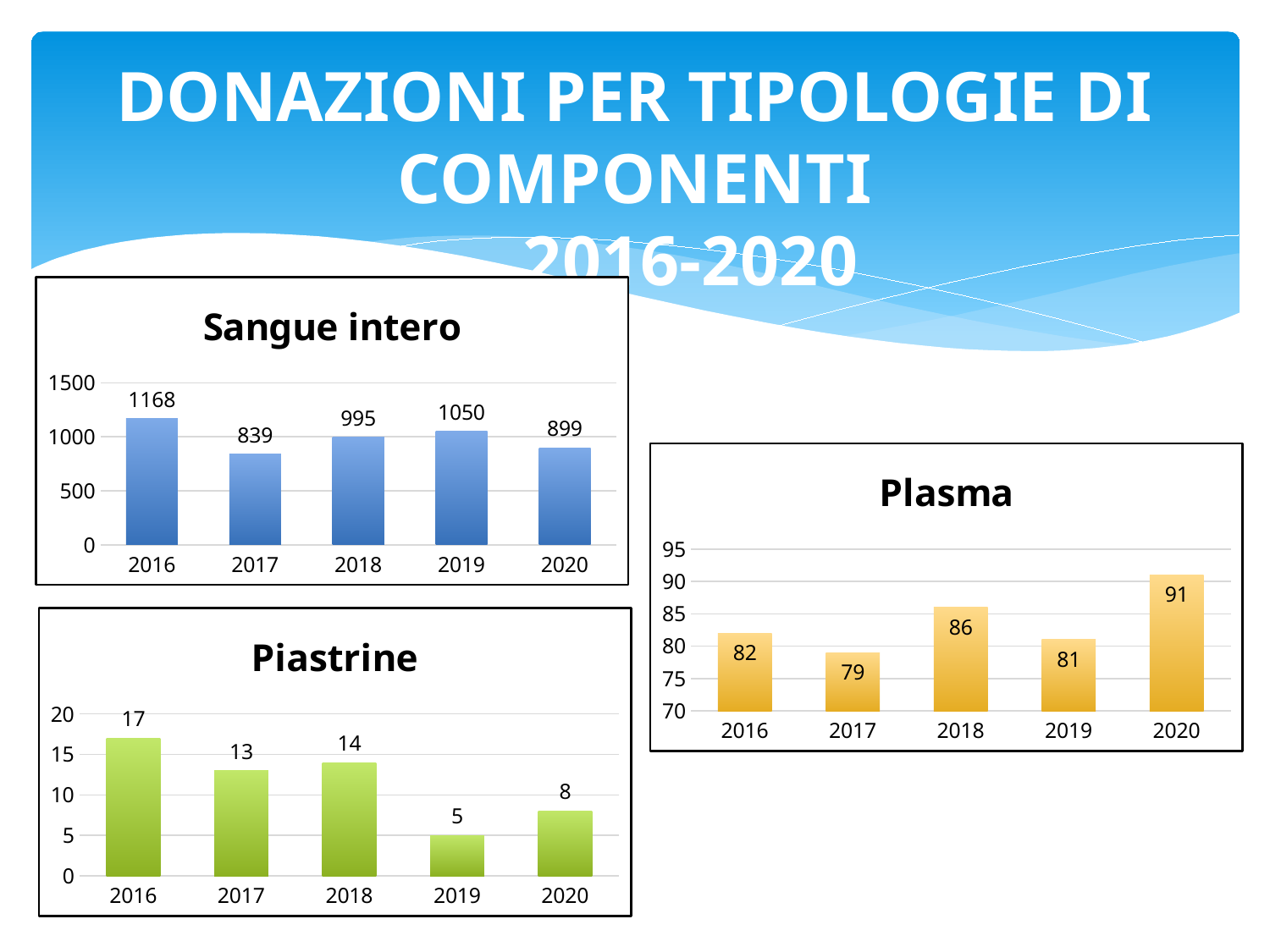
In the 'Sangue intero' chart, which year has the lowest value? 2017 In the 'Sangue intero' chart, what is the difference between the values for 2019 and 2020? 151 In the 'Plasma' chart, which year has the highest value? 2020 In the 'Sangue intero' chart, what is the value for 2016? 1168 In the 'Piastrine' chart, which year has the highest value? 2016 How many charts are shown on the slide? 3 In the 'Plasma' chart, what is the difference between the values for 2020 and 2017? 12 How many years are shown on the x axis of the 'Plasma' chart? 5 What kind of chart is the 'Piastrine' chart? bar chart In the 'Piastrine' chart, what is the value for 2019? 5 In the 'Plasma' chart, what is the value for 2018? 86 In the 'Piastrine' chart, which is larger, the value for 2017 or the value for 2018? 2018